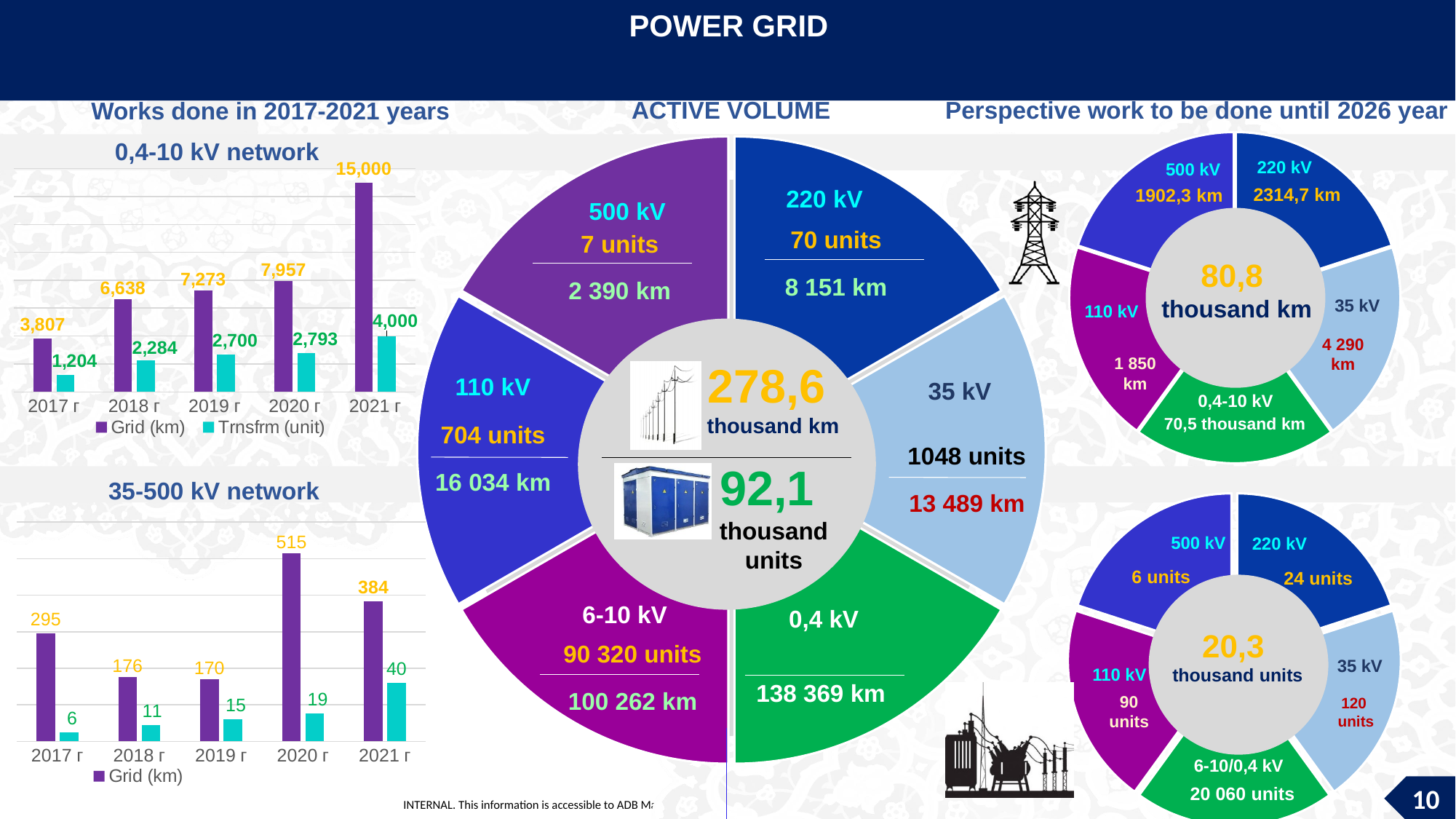
In the '0,4-10 kV network' chart, which year has the lowest Grid (km) value? 2017 What type of chart is the '35-500 kV network' chart? bar chart In the '35-500 kV network' chart, what is the Grid (km) value for 2020? 515 In the '0,4-10 kV network' chart, do the Trnsfrm (unit) values rise or fall from 2017 to 2021? rise In the '35-500 kV network' chart, which year has the highest Grid (km) value? 2020 In the 'ACTIVE VOLUME' donut chart, how many km are shown for the 220 kV segment? 8 151 km In the '35-500 kV network' chart, is the Grid (km) value for 2018 or 2019 larger? 2018 In the '0,4-10 kV network' chart, what is the difference between the Grid (km) values for 2021 and 2020? 7,043 In the '35-500 kV network' chart, how many years are shown on the x axis? 5 In the '0,4-10 kV network' chart, what is the Grid (km) value for 2021? 15,000 In the '0,4-10 kV network' chart, what is the Trnsfrm (unit) value for 2019? 2,700 In the '0,4-10 kV network' chart, how many series does the legend list? 2